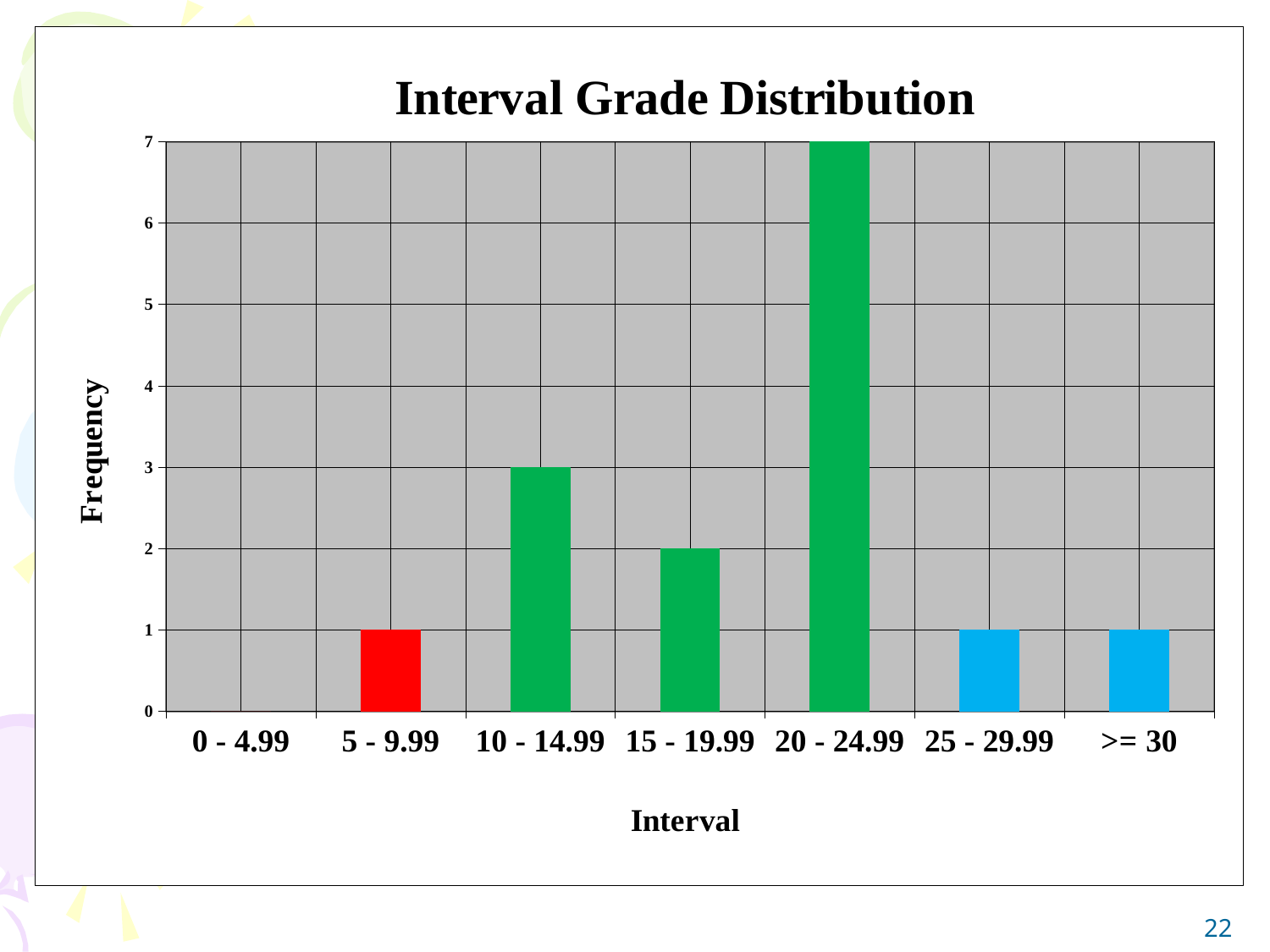
What is the title of the chart? Interval Grade Distribution Which interval has the highest frequency? 20 - 24.99 How many intervals are shown on the x axis? 7 What is the difference in frequency between the 20 - 24.99 interval and the 10 - 14.99 interval? 4 What is the frequency for the 0 - 4.99 interval? 0 Which has a higher frequency, the 10 - 14.99 interval or the 15 - 19.99 interval? 10 - 14.99 Which interval has the lowest frequency? 0 - 4.99 What is the frequency for the 10 - 14.99 interval? 3 What type of chart is shown on the slide? Bar chart What is the frequency for the 20 - 24.99 interval? 7 What colour is the bar for the 5 - 9.99 interval? Red What is the frequency for the 15 - 19.99 interval? 2